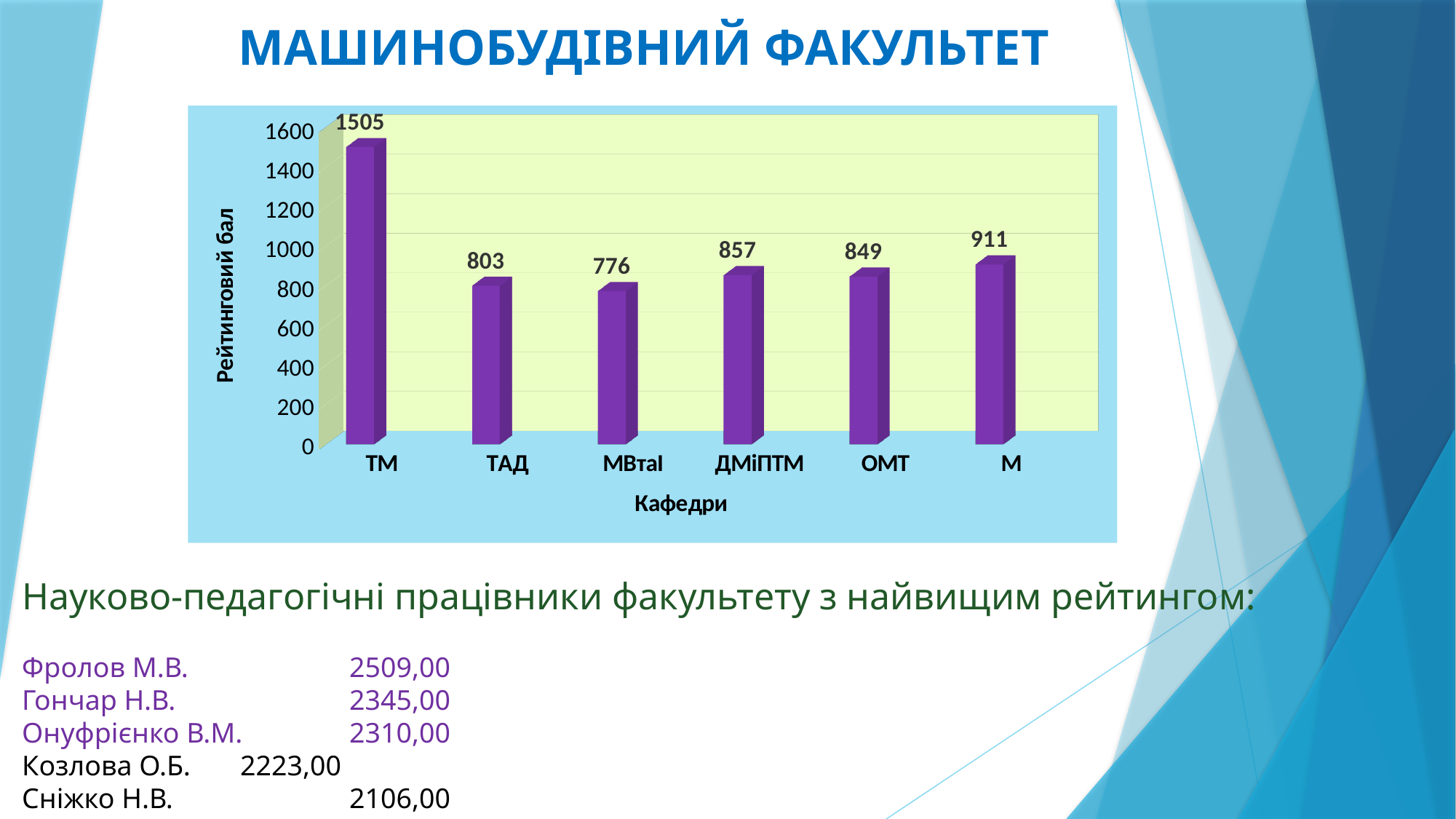
Which department has a higher rating score, ТАД or М? М Which department has the highest rating score? ТМ What is the difference between the rating scores of ТМ and ТАД? 702 What type of chart is shown on the slide? bar chart What is the rating score for the М department? 911 Which department has the lowest rating score? МВтаІ What is the rating score for the ДМіПТМ department? 857 What is the difference between the rating scores of ДМіПТМ and ОМТ? 8 What is the rating score (Рейтинговий бал) for the ТМ department? 1505 What is the label of the vertical axis of the chart? Рейтинговий бал How many departments (Кафедри) are shown on the chart? 6 Is the rating score for ОМТ greater or less than 1000? less